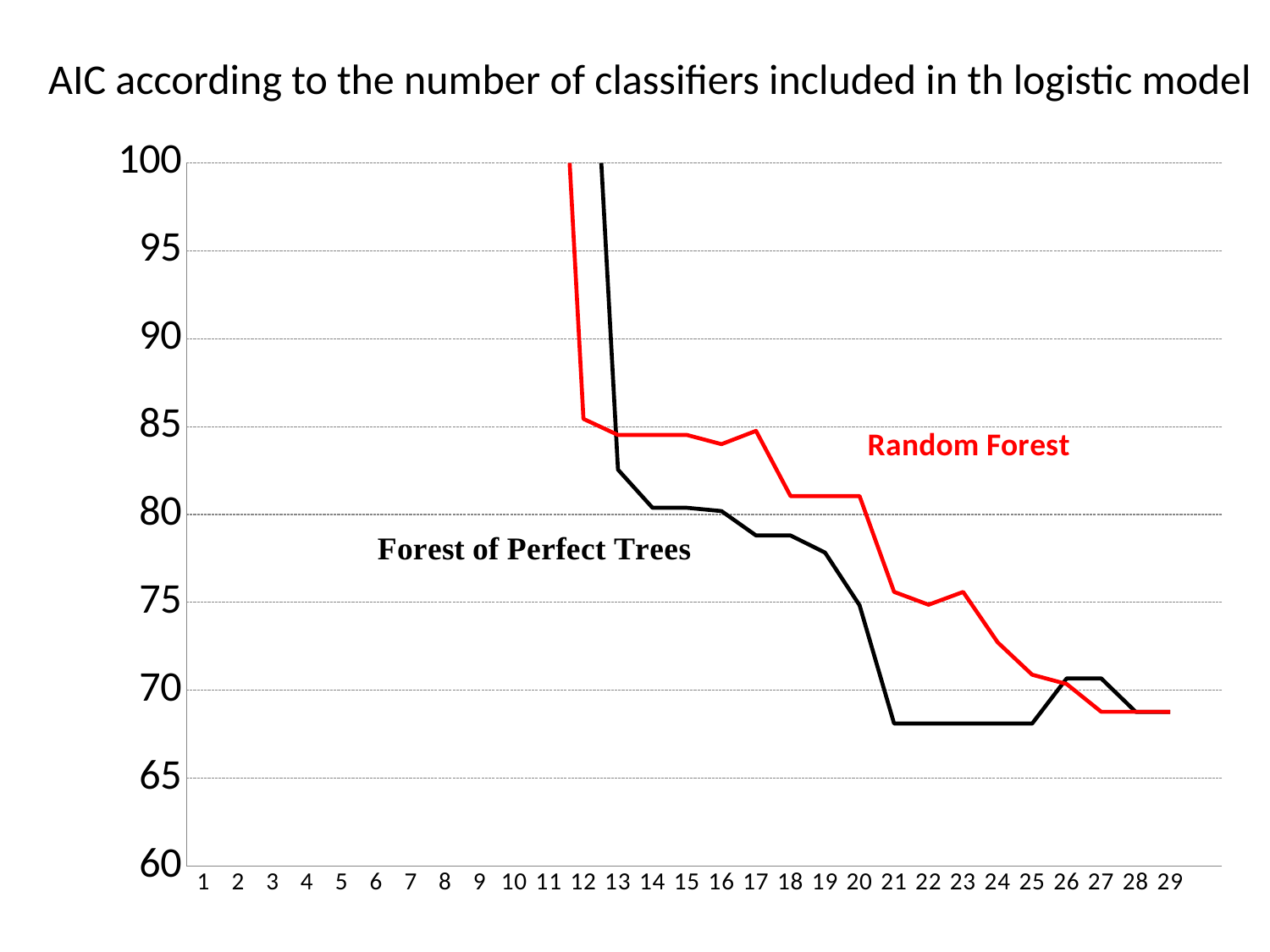
Is the value for Random Forest at 20 classifiers greater or less than 80? greater How many series are plotted on the chart? 2 At 27 classifiers, which series has the higher AIC, Random Forest or Forest of Perfect Trees? Forest of Perfect Trees Is the value for Forest of Perfect Trees at 17 classifiers greater or less than 80? less What colour is the line for Random Forest? red Do the AIC values for Random Forest generally rise or fall as the number of classifiers increases? fall How many points are labelled along the x axis? 29 At 20 classifiers, which series has the higher AIC, Random Forest or Forest of Perfect Trees? Random Forest Is the value for Random Forest at 24 classifiers greater or less than 70? greater Do the AIC values for Forest of Perfect Trees generally rise or fall as the number of classifiers increases? fall What kind of chart is shown on the slide? line chart